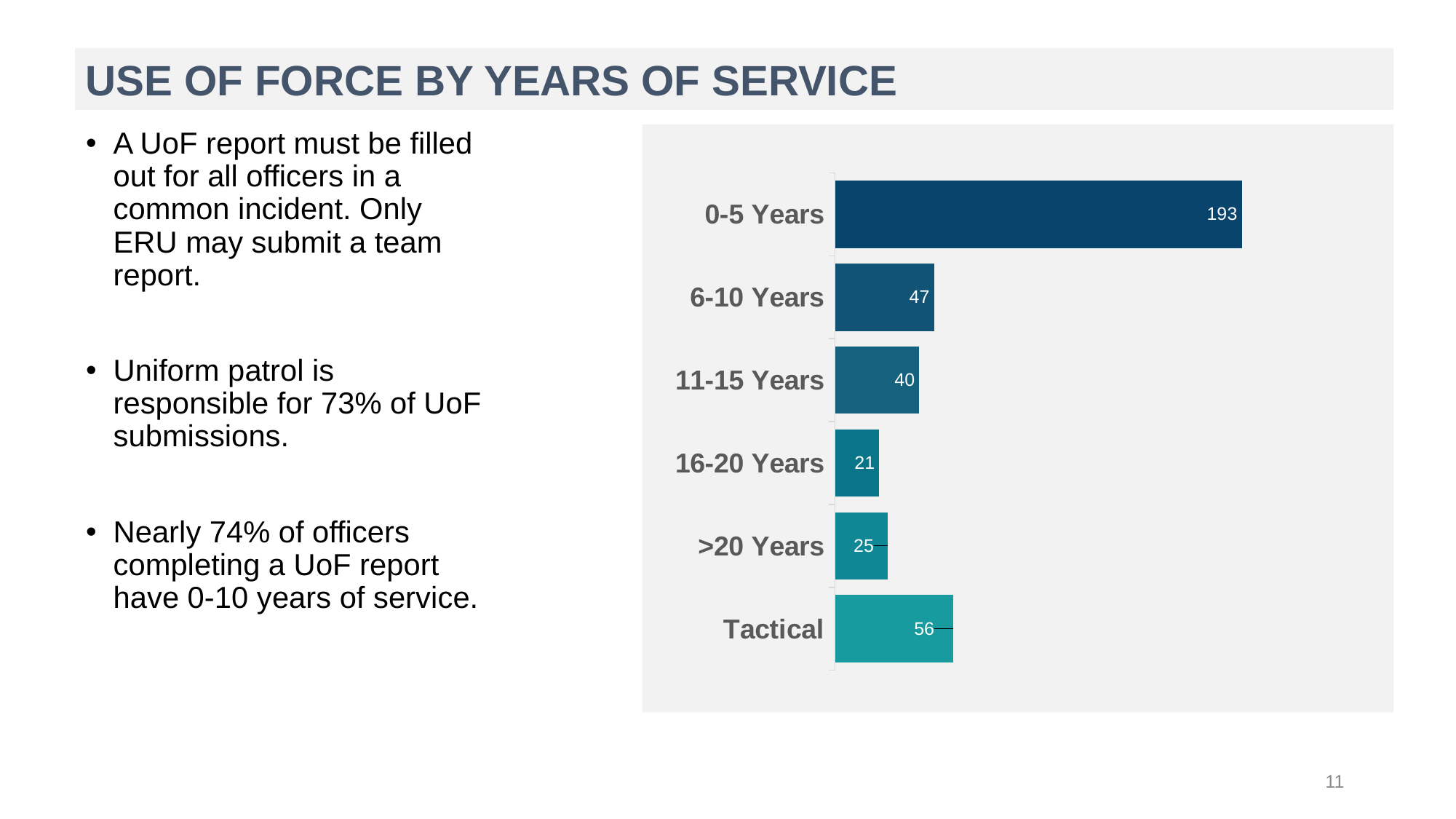
Which is larger, the value for 11-15 Years or the value for >20 Years? 11-15 Years What is the value for 6-10 Years? 47 What is the value for 0-5 Years? 193 What is the difference between the values for 0-5 Years and 6-10 Years? 146 What is the value for Tactical? 56 What kind of chart is shown on the slide? Bar chart What is the title of the slide containing the chart? USE OF FORCE BY YEARS OF SERVICE What is the difference between the values for Tactical and 11-15 Years? 16 How many categories are shown in the chart? 6 What is the value for >20 Years? 25 Which category has the lowest value? 16-20 Years Which category has the highest value? 0-5 Years